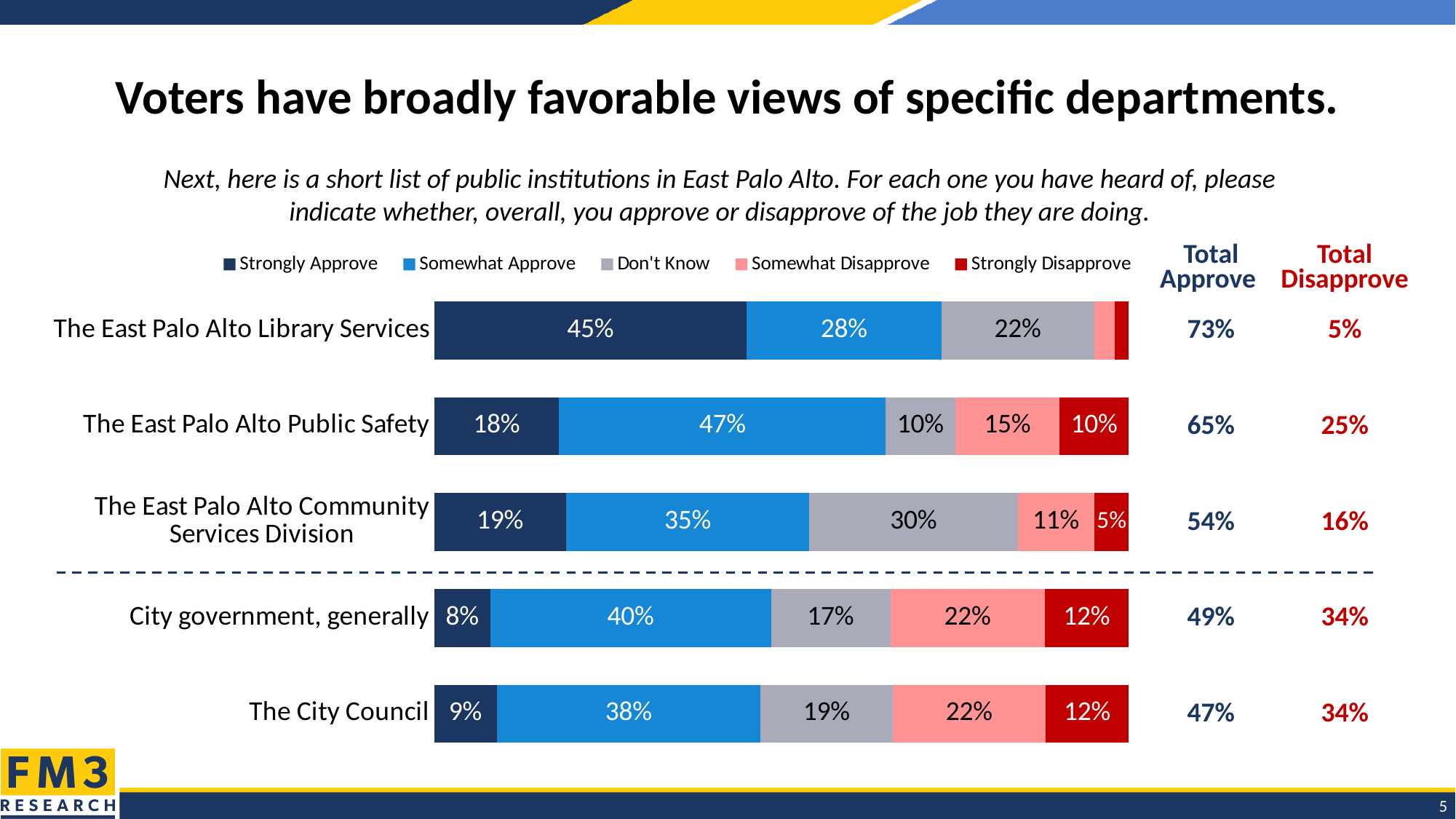
What percentage of voters strongly approve of The East Palo Alto Library Services? 45% What kind of chart is shown on the slide? Stacked bar chart What percentage of voters somewhat approve of The East Palo Alto Public Safety? 47% How many series does the legend list? 5 What percentage of voters strongly disapprove of The City Council? 12% What is the Total Approve figure shown for The East Palo Alto Public Safety? 65% What is the Don't Know percentage for The East Palo Alto Community Services Division? 30% How many institutions are shown in the chart? 5 What is the difference between the Somewhat Approve percentages for The East Palo Alto Public Safety and The City Council? 9% Which institution has the highest Strongly Approve percentage? The East Palo Alto Library Services Which institution has the lowest Strongly Approve percentage? City government, generally Which is larger: the Don't Know percentage for The East Palo Alto Library Services or for City government, generally? The East Palo Alto Library Services